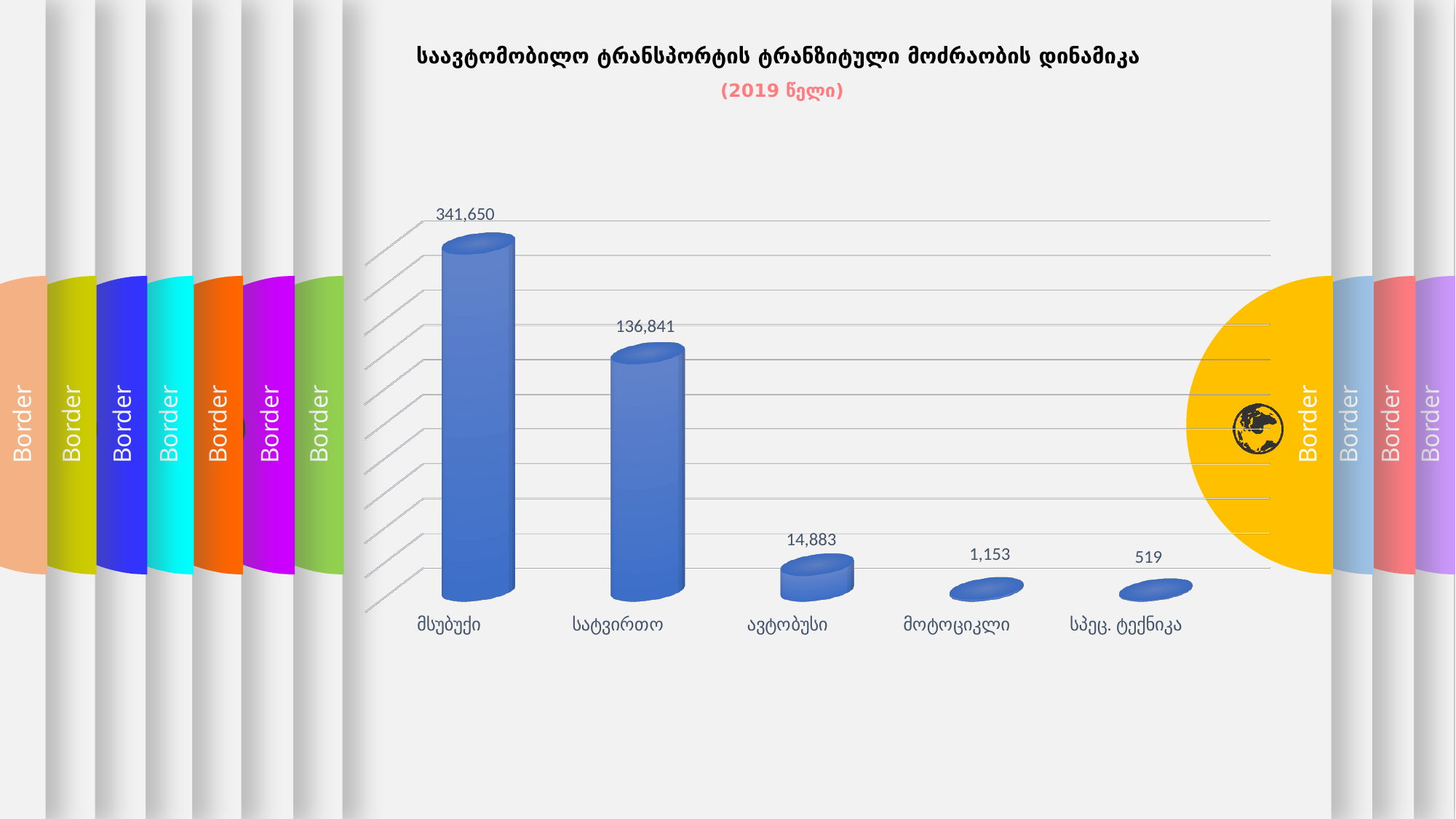
What is the value for ავტობუსი? 14,883 What is the difference between the values for მსუბუქი and სატვირთო? 204,809 What kind of chart is shown on the slide? Bar chart What is the value for მოტოციკლი? 1,153 Which category has the highest value? მსუბუქი What is the value for სატვირთო? 136,841 What is the value for მსუბუქი? 341,650 Which category has the lowest value? სპეც. ტექნიკა How many categories are shown on the chart? 5 What is the value for სპეც. ტექნიკა? 519 Which is larger, the value for ავტობუსი or the value for მოტოციკლი? ავტობუსი Which year is given in the chart's subtitle? 2019